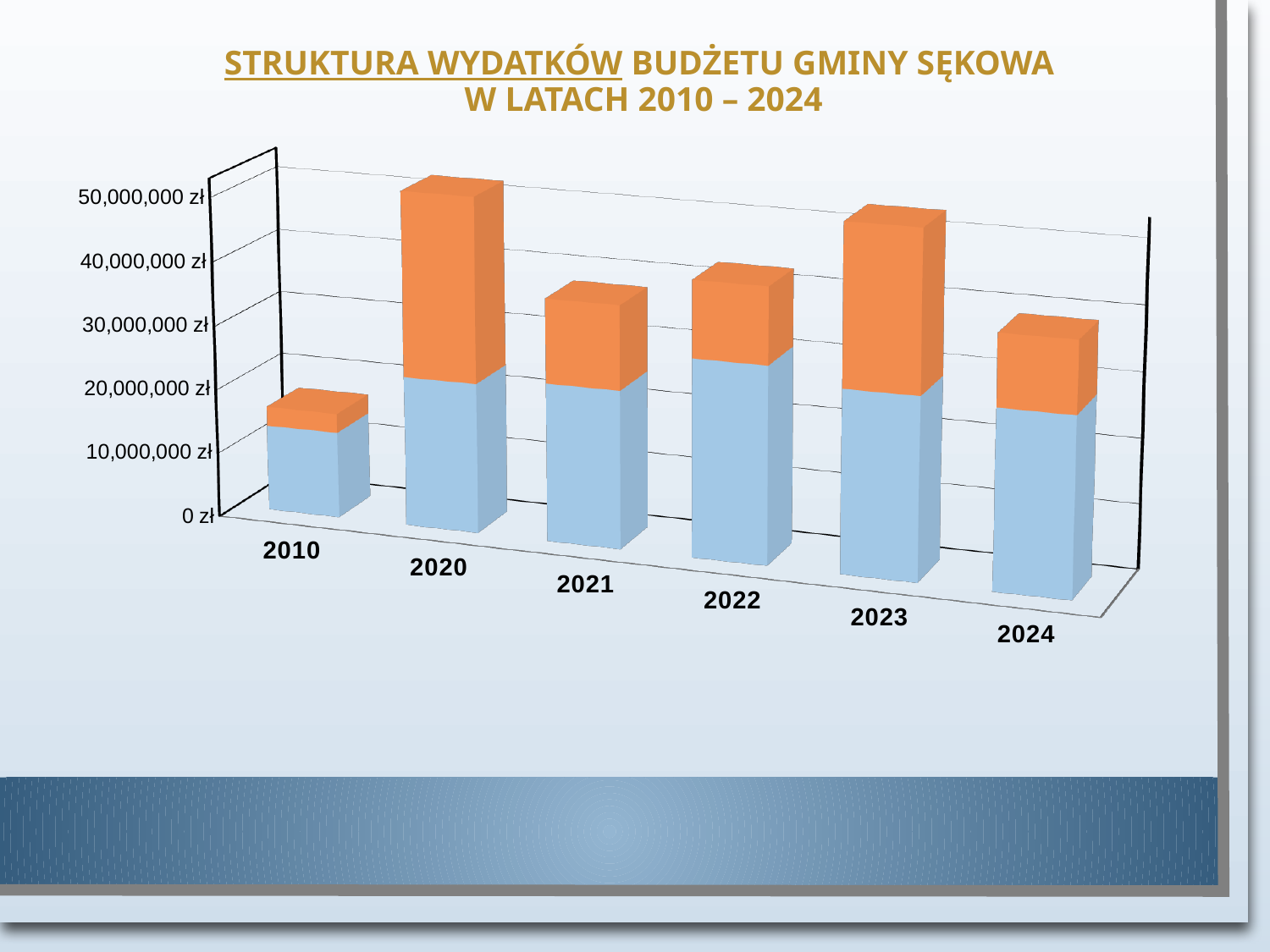
How many years (categories) are shown on the x axis of the chart? 6 Is the total value for 2010 greater or less than 10,000,000 zł? greater Is the total value for 2023 greater or less than 30,000,000 zł? greater Which year has the larger total bar, 2023 or 2024? 2023 Which year has the highest total bar in the chart? 2023 Which year has the larger total bar, 2020 or 2021? 2020 What is the title of the chart on the slide? STRUKTURA WYDATKÓW BUDŻETU GMINY SĘKOWA W LATACH 2010 – 2024 How many stacked segments (series) make up each bar in the chart? 2 Which year has the lowest total bar in the chart? 2010 What kind of chart is shown on the slide? Stacked bar chart Which year has the larger total bar, 2010 or 2024? 2024 Does the total bar height rise or fall from 2010 to 2020? rise